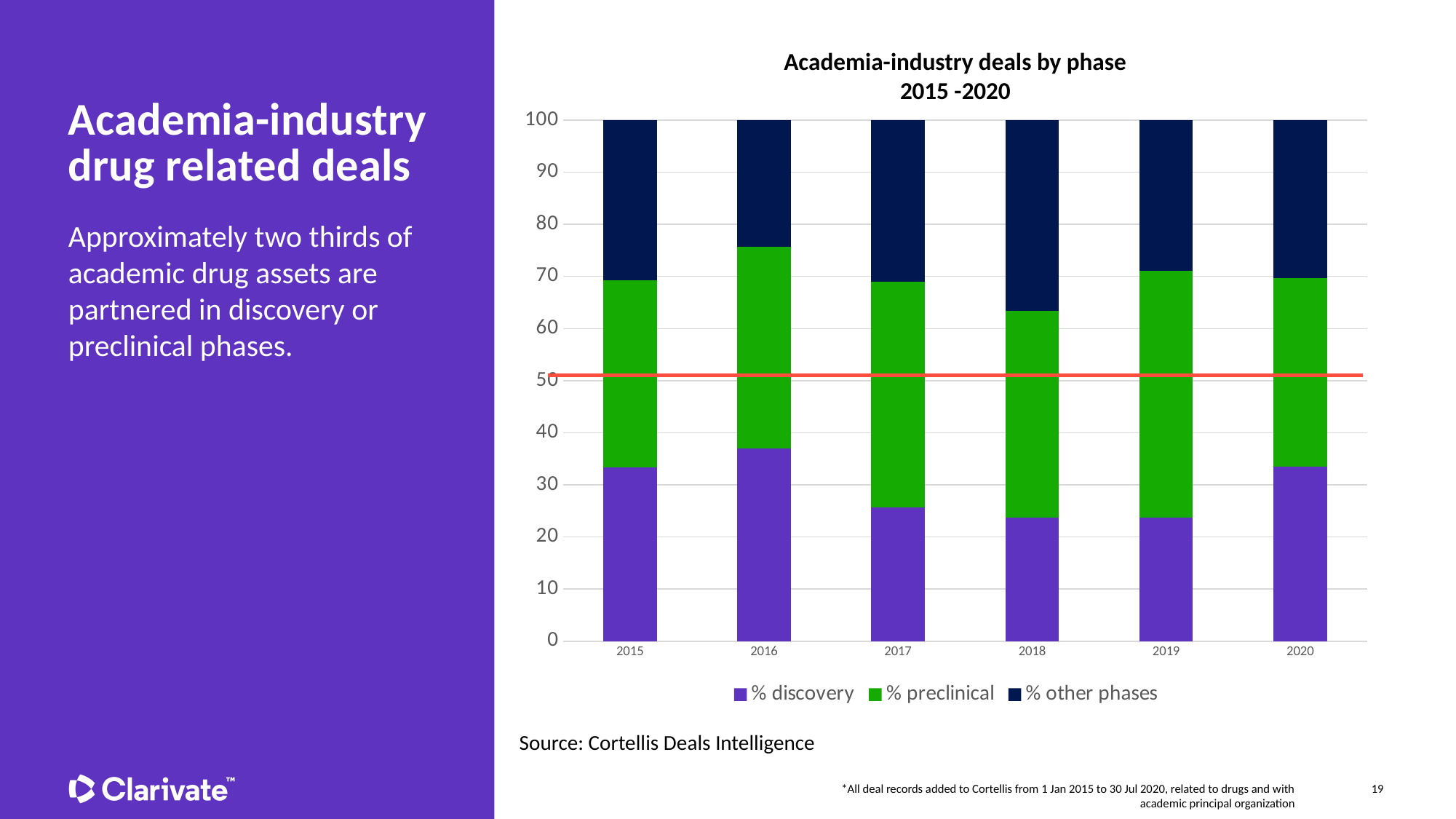
What kind of chart is shown on the slide? Stacked bar chart Which year has the larger % discovery segment, 2016 or 2017? 2016 In which year is the % other phases segment the largest? 2018 Is the % discovery value for 2016 greater or less than 30? greater What is the title of the chart? Academia-industry deals by phase 2015 -2020 What is the total of the stacked bar for 2015? 100 In which year is the % other phases segment the smallest? 2016 Which series is shown in green in the chart? % preclinical How many years are shown on the x axis of the chart? 6 How many series does the chart legend list? 3 In which year is the % discovery segment the largest? 2016 Is the % discovery value for 2018 greater or less than 30? less